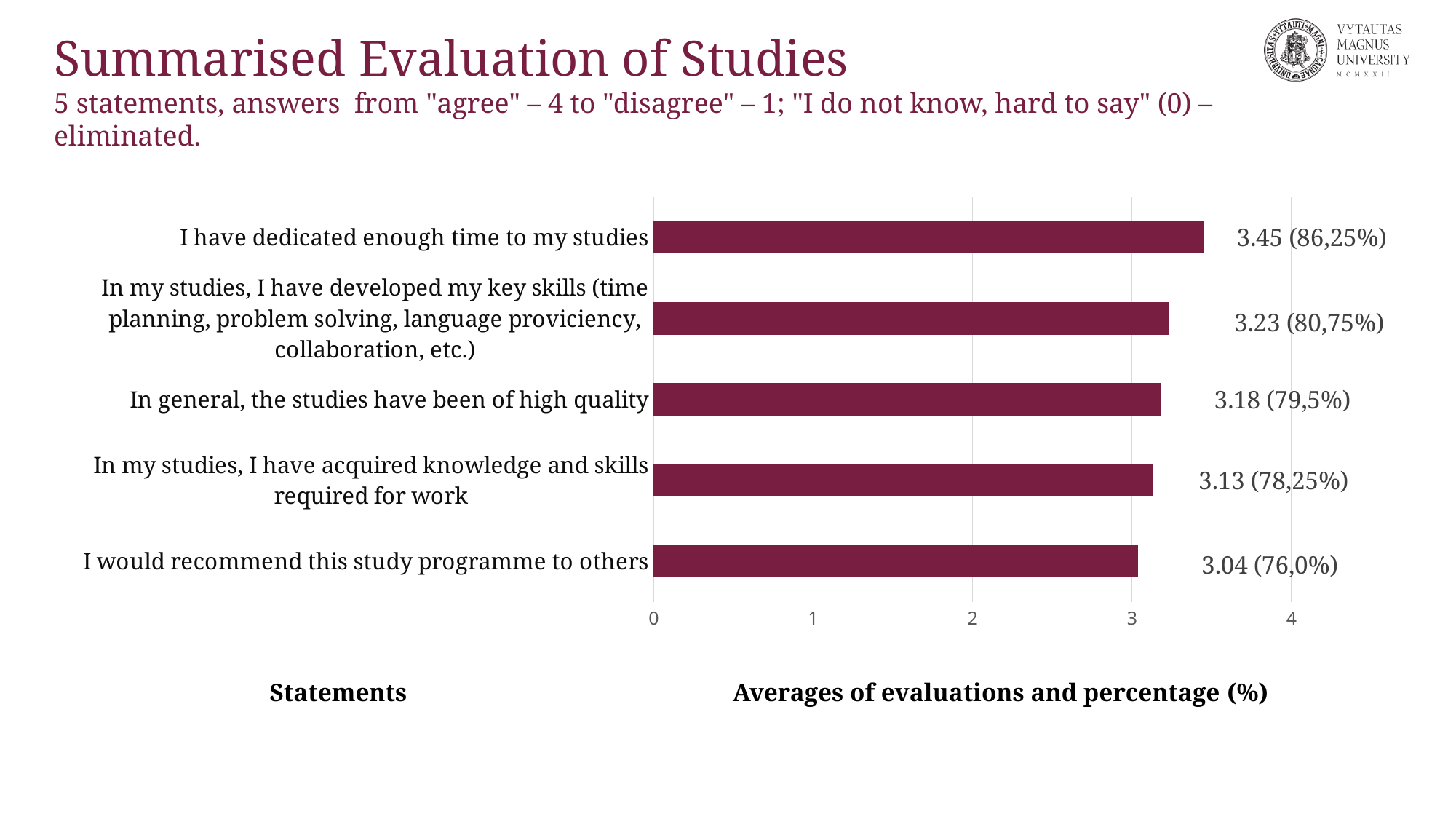
What is the average evaluation for "I would recommend this study programme to others"? 3.04 Is the value for "I would recommend this study programme to others" greater or less than 3? greater What is the data label for "I have dedicated enough time to my studies"? 3.45 (86,25%) What is the average evaluation for "In my studies, I have acquired knowledge and skills required for work"? 3.13 What is the label under the horizontal axis of the chart? Averages of evaluations and percentage (%) What is the difference between the average evaluations for "I have dedicated enough time to my studies" and "I would recommend this study programme to others"? 0.41 Which statement has the highest average evaluation? I have dedicated enough time to my studies What kind of chart is shown on the slide? bar chart How many statements are plotted in the chart? 5 Which statement has the lowest average evaluation? I would recommend this study programme to others Which has a higher average evaluation: "In general, the studies have been of high quality" or "In my studies, I have developed my key skills (time planning, problem solving, language proviciency, collaboration, etc.)"? In my studies, I have developed my key skills (time planning, problem solving, language proviciency, collaboration, etc.) What percentage is shown for "In general, the studies have been of high quality"? 79,5%